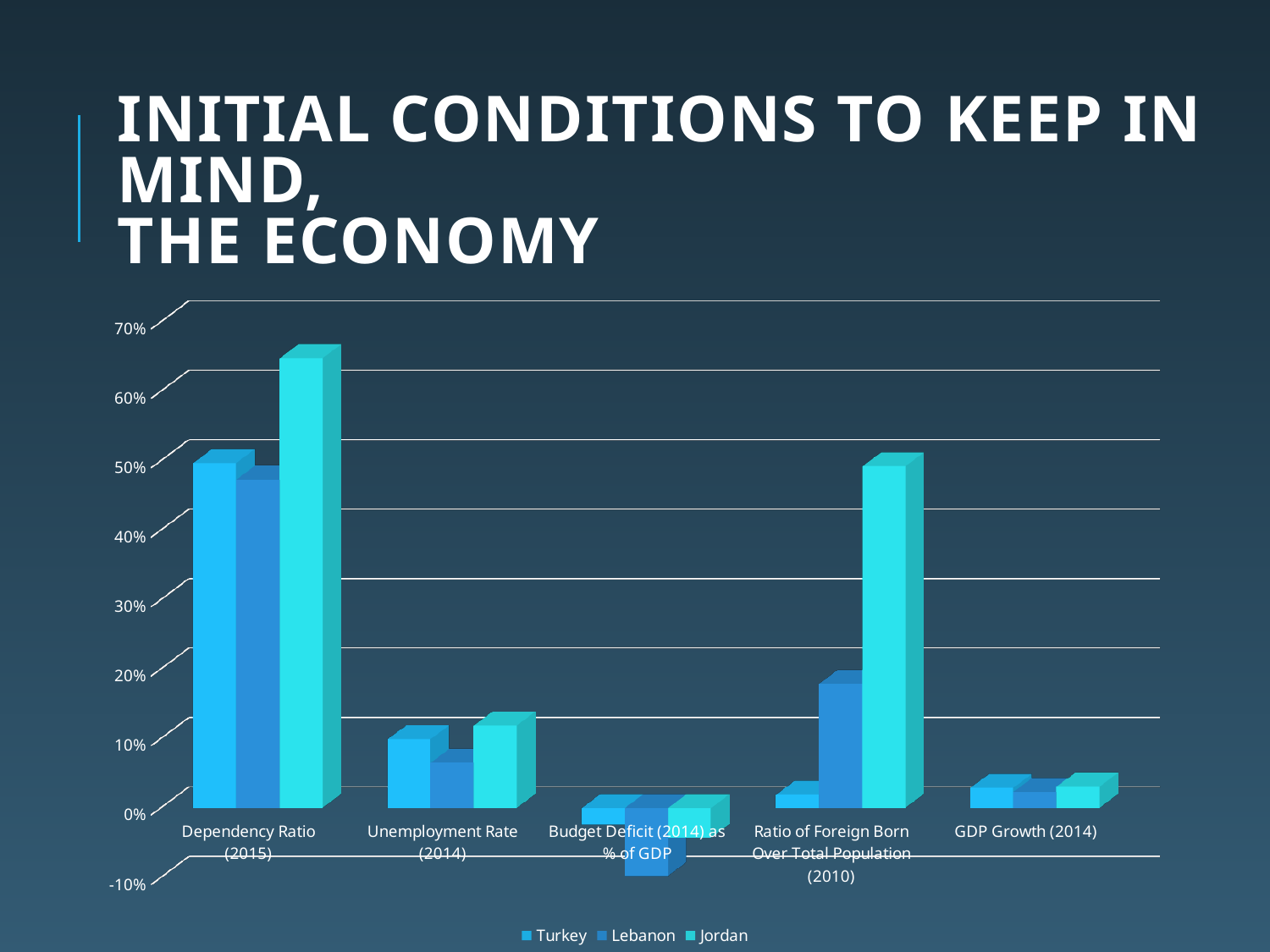
Which country has the lowest Unemployment Rate (2014)? Lebanon Which country has the highest Dependency Ratio (2015)? Jordan Is Turkey's Dependency Ratio (2015) greater or less than 40%? greater Which country has the lowest Ratio of Foreign Born Over Total Population (2010)? Turkey Which country has the highest Ratio of Foreign Born Over Total Population (2010)? Jordan Is Lebanon's Ratio of Foreign Born Over Total Population (2010) greater or less than 20%? less How many categories are shown along the x axis of the chart? 5 Is Jordan's Dependency Ratio (2015) greater or less than 60%? greater What kind of chart is shown on the slide? bar chart How many series does the chart's legend list? 3 Which countries are listed in the chart's legend? Turkey, Lebanon, Jordan Which country has the largest Budget Deficit (2014) as % of GDP, i.e. the most negative bar? Lebanon